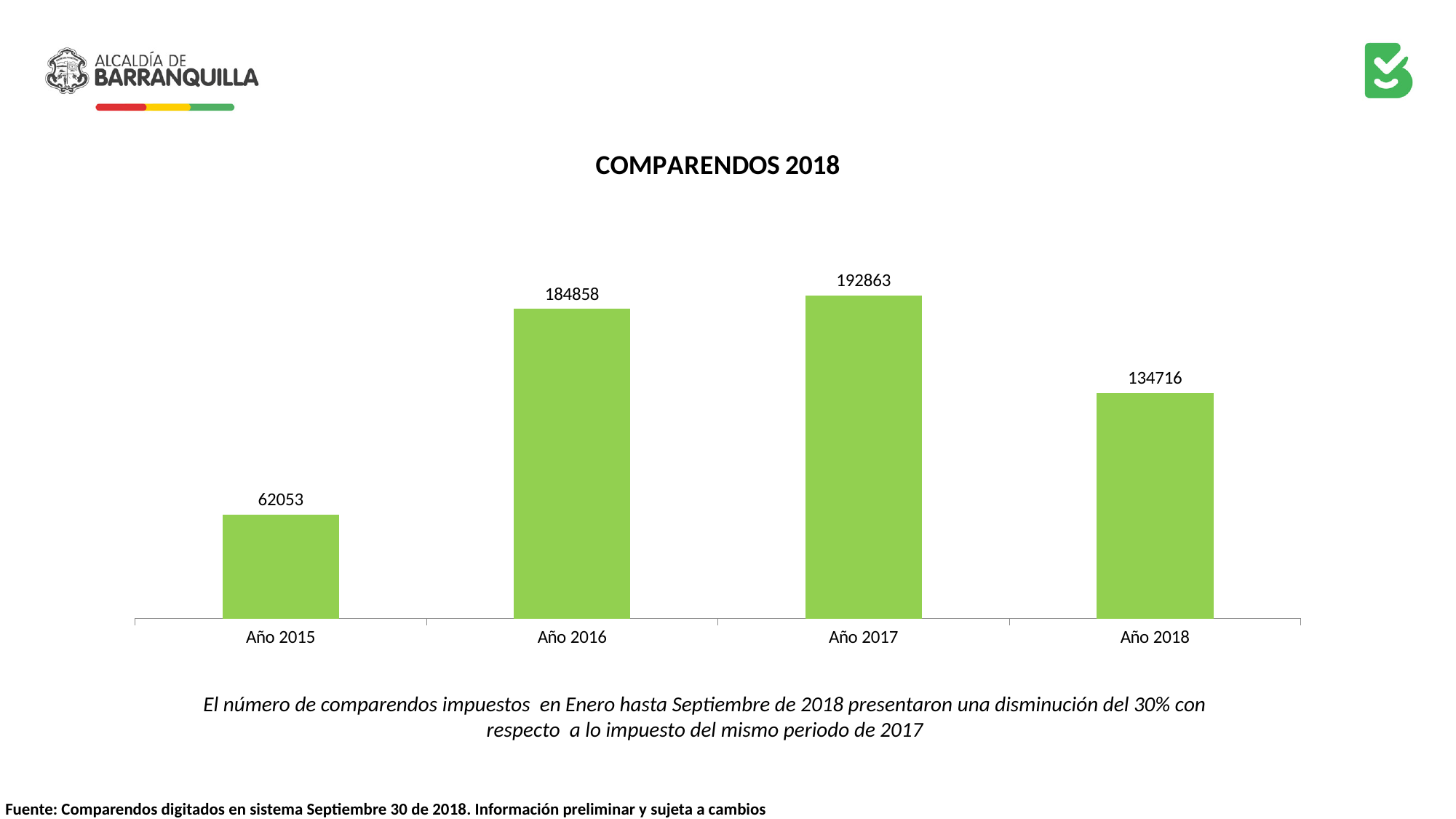
What is the value for Año 2017? 192863 How many years are shown on the chart? 4 What is the value for Año 2016? 184858 What kind of chart is shown on the slide? Bar chart Which year has the lowest value? Año 2015 What is the value for Año 2018? 134716 Which is larger, the value for Año 2016 or the value for Año 2018? Año 2016 Which year has the highest value? Año 2017 What is the difference between the values for Año 2016 and Año 2015? 122805 What is the value for Año 2015? 62053 What is the difference between the values for Año 2017 and Año 2018? 58147 What is the title of the chart? COMPARENDOS 2018